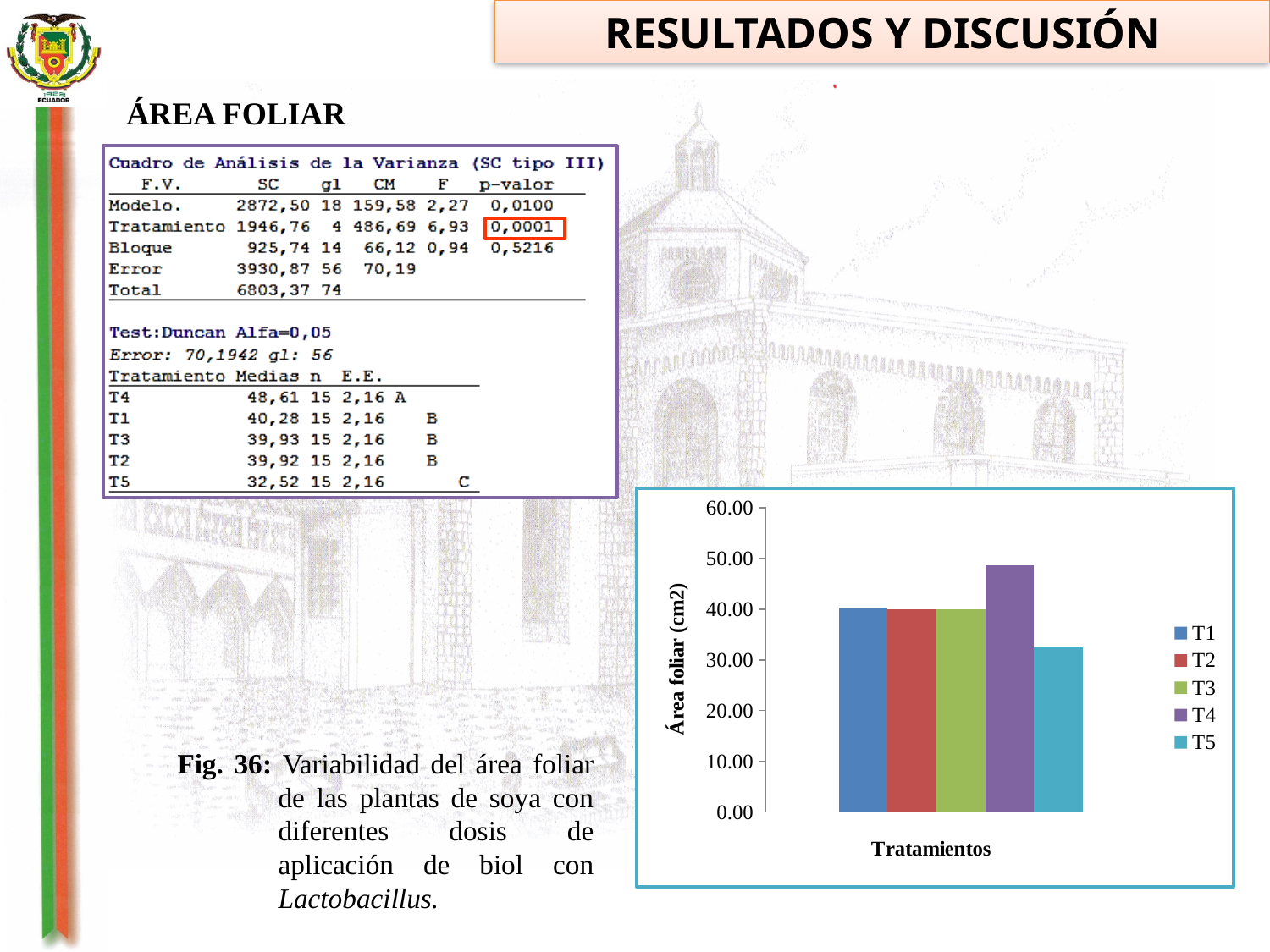
Which is larger, the value for T4 or the value for T5? T4 What is the label of the vertical axis of the chart? Área foliar (cm2) What is the label of the horizontal axis of the chart? Tratamientos How many bars are plotted in the chart? 5 Is the value for T4 greater or less than 50.00? less Is the value for T4 greater or less than 40.00? greater What kind of chart is shown on the slide? bar chart Is the value for T5 greater or less than 40.00? less Which treatment has the lowest área foliar in the chart? T5 How many series does the chart legend list? 5 Which treatment has the highest área foliar in the chart? T4